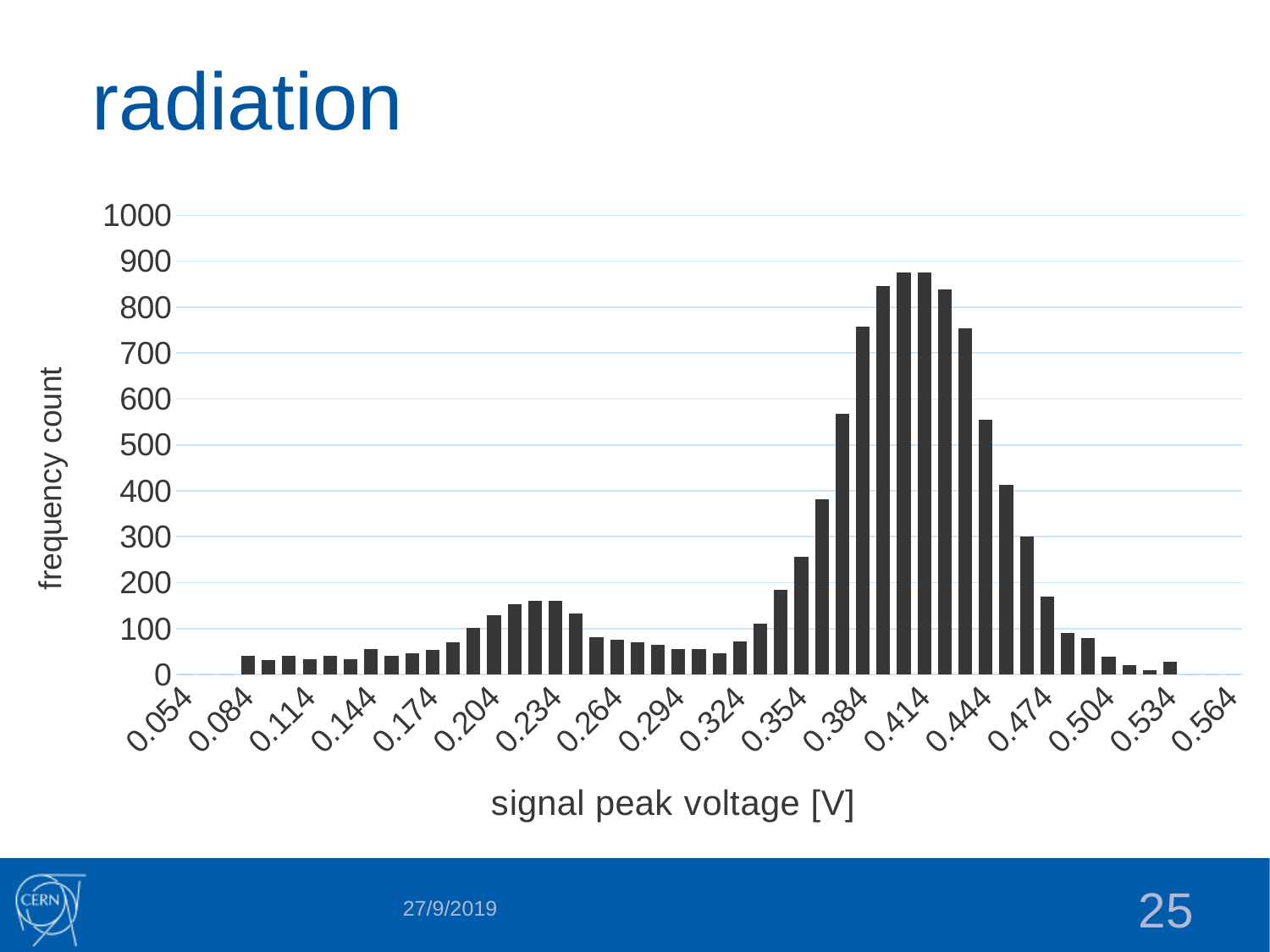
Do the frequency counts rise or fall as the signal peak voltage goes from 0.414 V to 0.504 V? fall Is the frequency count at 0.084 V greater or less than 100? less What is the title of the y axis? frequency count Do the frequency counts rise or fall as the signal peak voltage goes from 0.354 V to 0.414 V? rise Is the frequency count at 0.474 V greater or less than 400? less What is the title of the x axis? signal peak voltage [V] What kind of chart is shown on the slide? bar chart Is the frequency count at 0.504 V greater or less than 100? less Which has the larger frequency count, 0.414 V or 0.234 V? 0.414